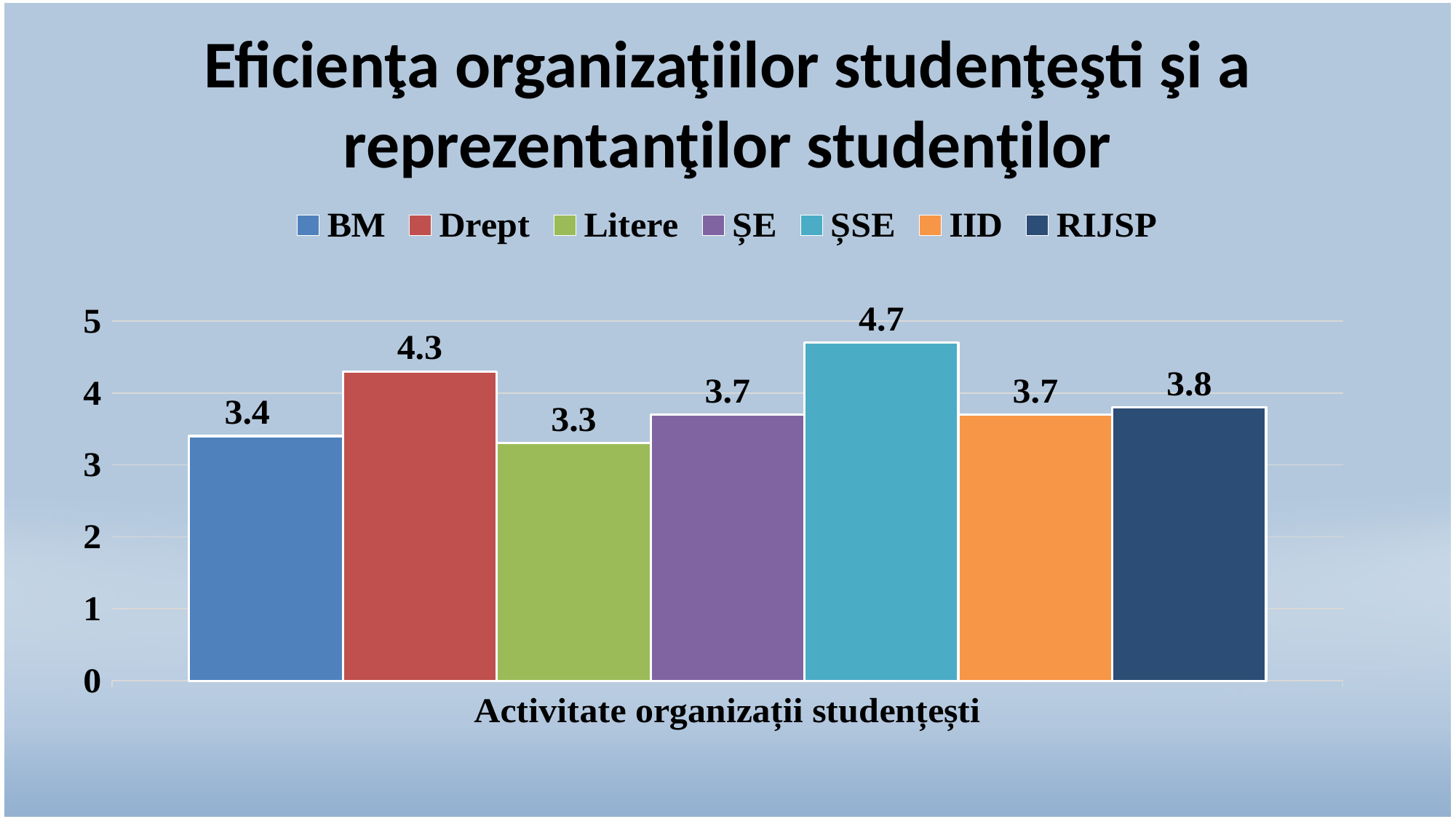
How many series does the legend list? 7 What kind of chart is shown on the slide? bar chart Which series has the highest value? ŞSE What is the value for Drept? 4.3 What is the value for ŞSE? 4.7 What is the x-axis label of the chart? Activitate organizaţii studenţeşti What is the value for Litere? 3.3 Which is larger, the value for Drept or the value for RIJSP? Drept What is the difference between the values for ŞSE and BM? 1.3 Is the value for IID greater or less than 4? less Which series has the lowest value? Litere What colour is the bar for Drept? red